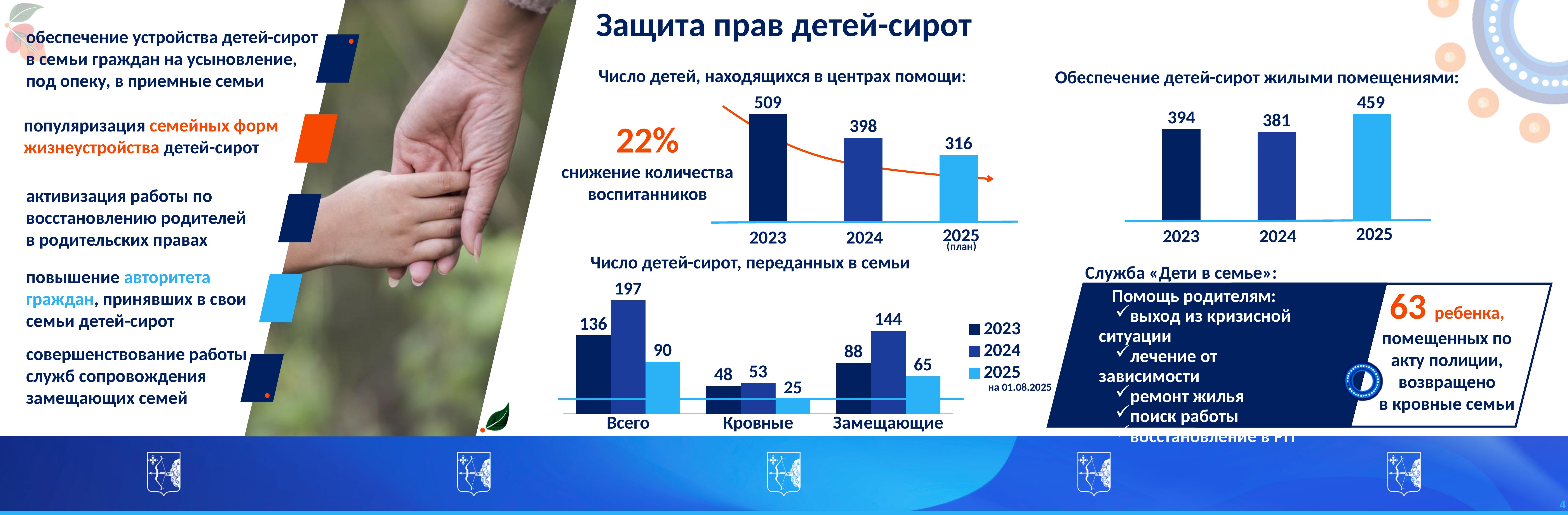
In the chart 'Число детей, находящихся в центрах помощи', do the values rise or fall from 2023 to 2025? fall In the chart 'Обеспечение детей-сирот жилыми помещениями', which year has the lowest value? 2024 In the chart 'Число детей, находящихся в центрах помощи', what is the value for 2023? 509 In the chart 'Число детей-сирот, переданных в семьи', what is the 2024 value for 'Всего'? 197 In the chart 'Число детей-сирот, переданных в семьи', which is larger: the 2023 value for 'Замещающие' or the 2025 value for 'Замещающие'? 2023 (88) In the chart 'Число детей, находящихся в центрах помощи', what is the value for 2025 (план)? 316 In the chart 'Число детей-сирот, переданных в семьи', how many series does the legend list? 3 In the chart 'Число детей-сирот, переданных в семьи', what is the 2025 value for 'Кровные'? 25 In the chart 'Обеспечение детей-сирот жилыми помещениями', which year has the highest value? 2025 In the chart 'Обеспечение детей-сирот жилыми помещениями', what is the value for 2024? 381 In the chart 'Число детей, находящихся в центрах помощи', what is the difference between the 2023 and 2024 values? 111 What kind of chart is 'Число детей-сирот, переданных в семьи'? bar chart